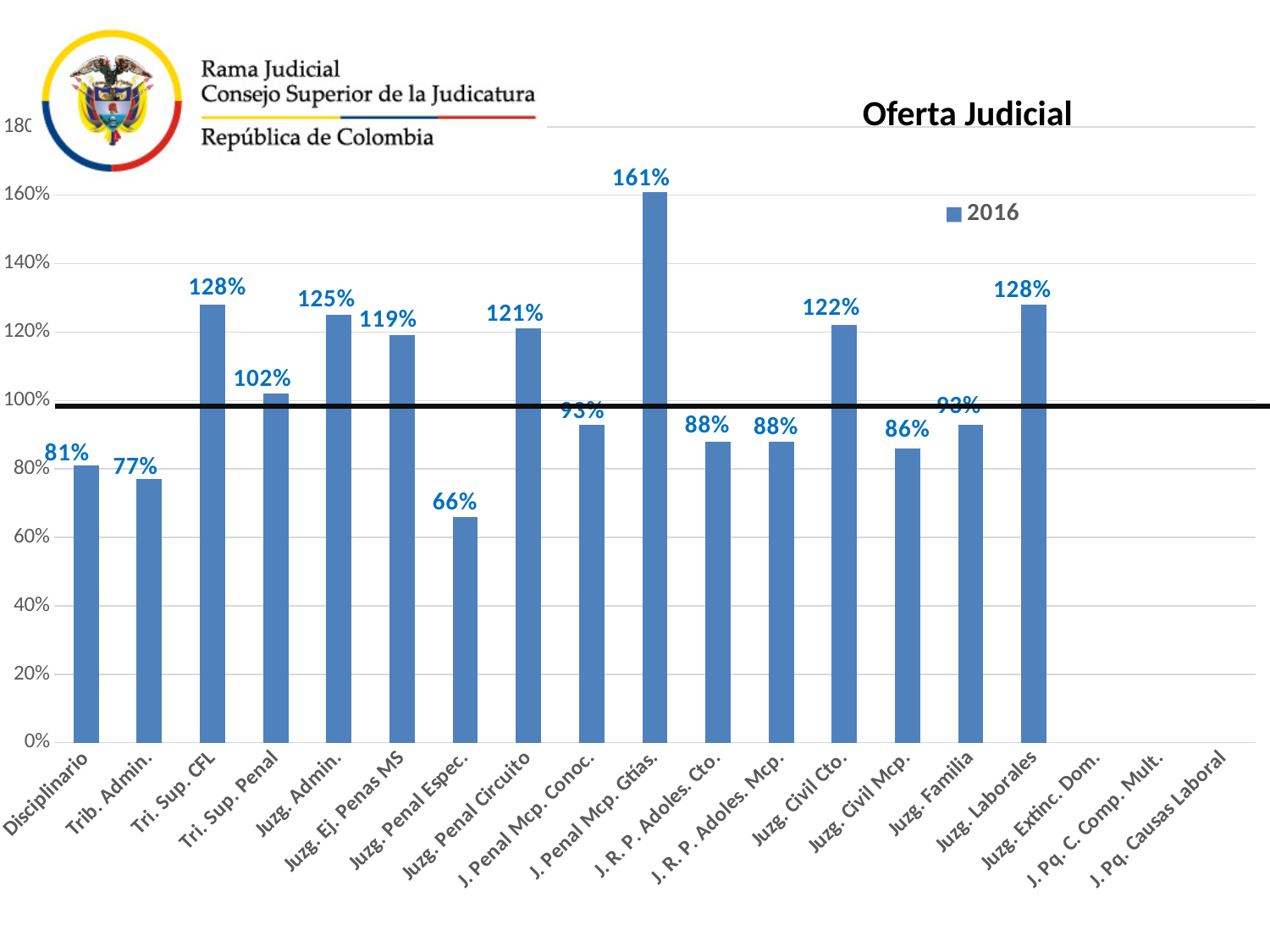
What is the value for Juzg. Civil Mcp.? 86% What is the difference between the values for Tri. Sup. CFL and Trib. Admin.? 51% What is the value for Tri. Sup. Penal? 102% Which is larger, the value for Juzg. Admin. or the value for Juzg. Civil Cto.? Juzg. Admin. What is the value for Juzg. Penal Espec.? 66% What kind of chart is shown on the slide? bar chart How many series does the legend list? 1 What is the title of the chart? Oferta Judicial Is the value for Disciplinario greater or less than 100%? less Which category has the lowest plotted value? Juzg. Penal Espec. What is the value for J. Penal Mcp. Gtías.? 161% Which category has the highest value? J. Penal Mcp. Gtías.